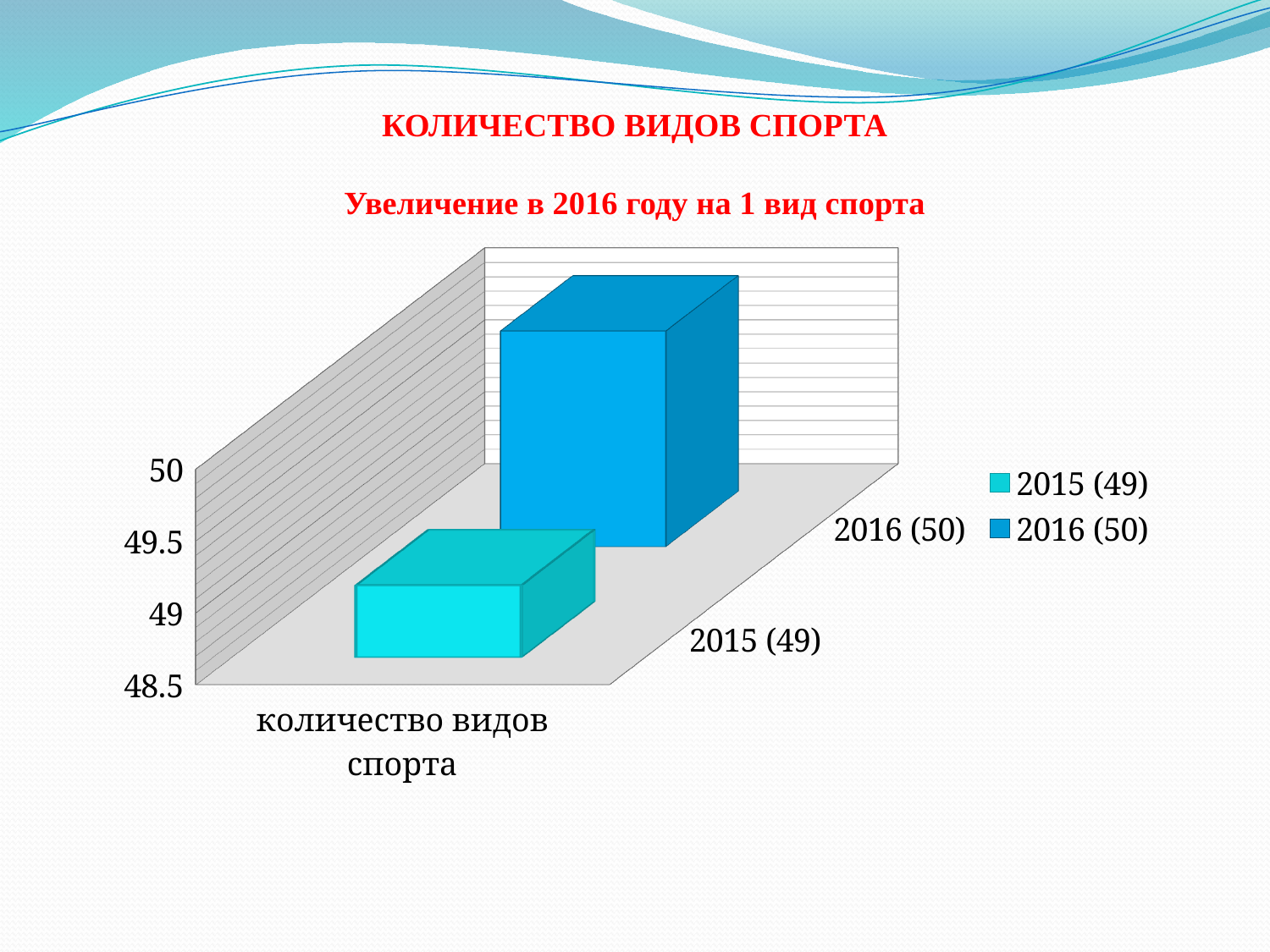
What kind of chart is shown on the slide? bar chart What is the value for the 2015 series, as shown in its legend label? 49 Is the value for 2016 greater or less than 49.5? greater Which series has the higher value, 2015 or 2016? 2016 Is the value for 2015 greater or less than 49.5? less Which series has the highest value? 2016 (50) How many categories are shown on the x axis? 1 How many series does the legend list? 2 What is the difference between the 2016 value and the 2015 value? 1 What is the title of the chart? КОЛИЧЕСТВО ВИДОВ СПОРТА Which series has the lowest value? 2015 (49) What is the value for the 2016 series, as shown in its legend label? 50